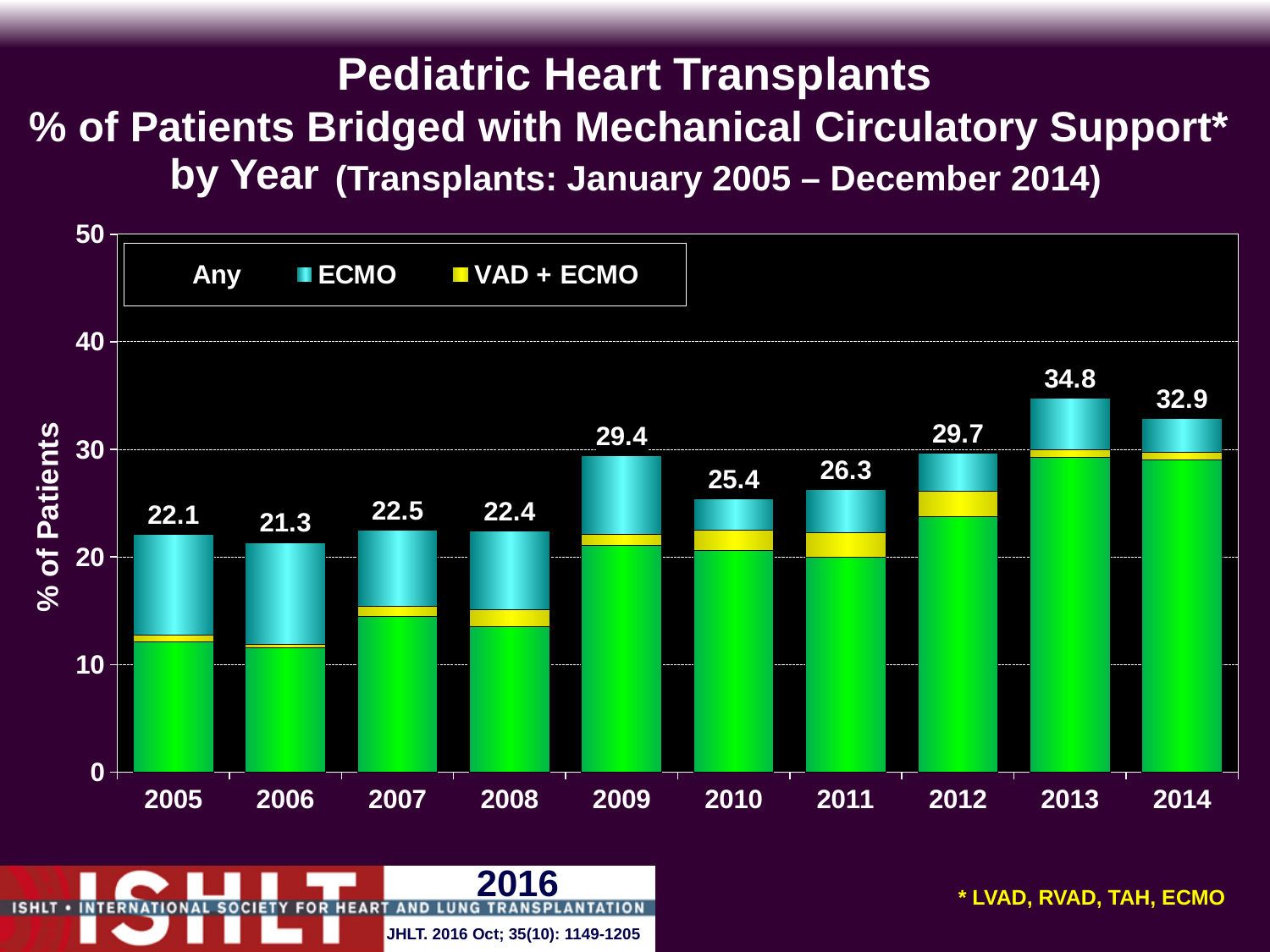
What is the labeled value for 2010? 25.4 What is the label of the y axis? % of Patients Which year has the lowest labeled value? 2006 Is the labeled value for 2014 greater or less than 30? greater How many series does the legend list? 3 What is the labeled value for 2006? 21.3 What is the difference between the labeled values for 2013 and 2005? 12.7 What kind of chart is shown on the slide? Stacked bar chart Which year has the highest labeled value? 2013 What is the labeled value for 2013? 34.8 How many years are shown on the x axis? 10 Which year has a larger labeled value, 2009 or 2012? 2012